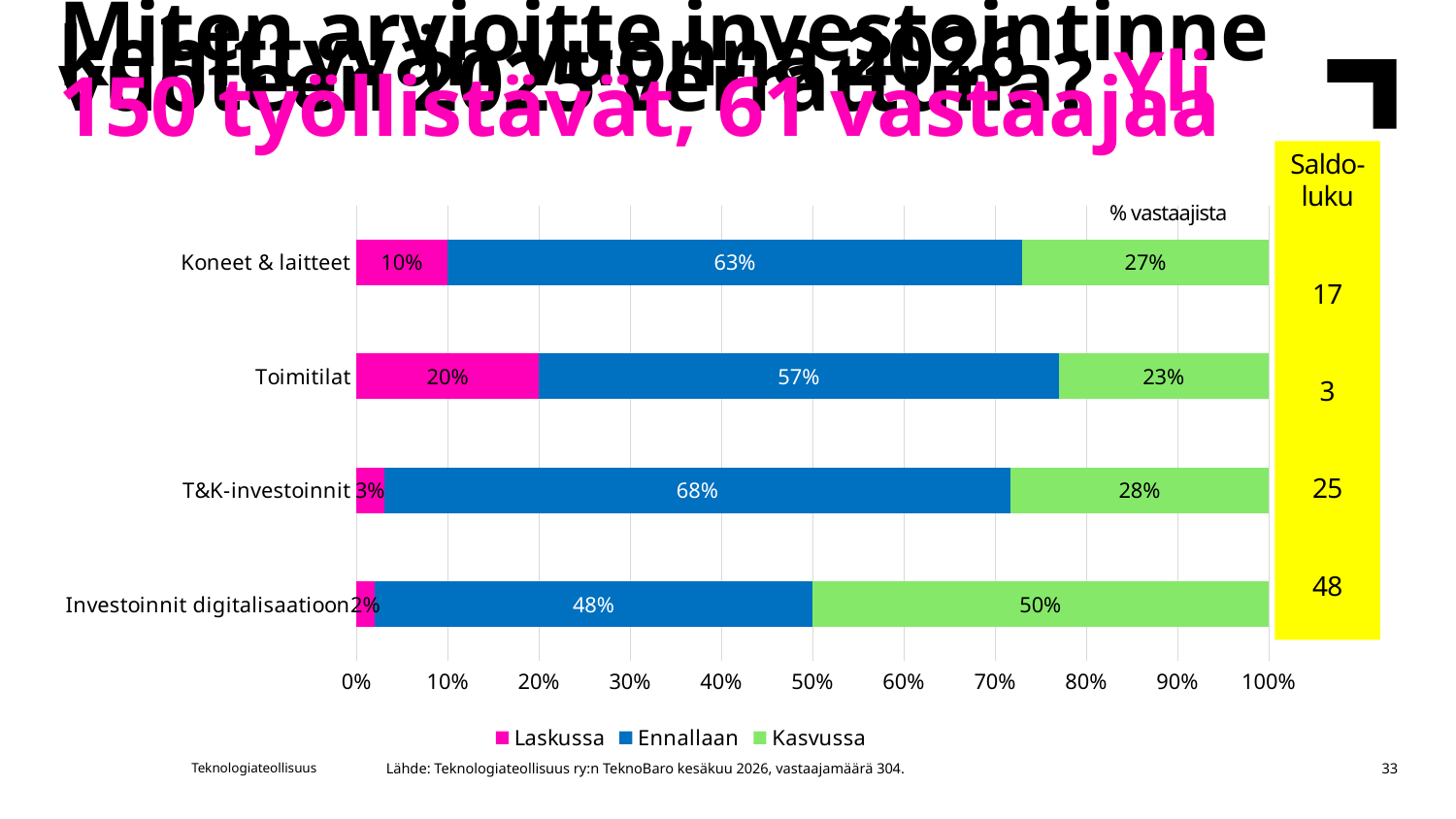
What is the Laskussa value for Toimitilat? 20% What is the Kasvussa value for Investoinnit digitalisaatioon? 50% How many categories are shown on the chart? 4 Which is larger, the Ennallaan value for T&K-investoinnit or for Toimitilat? T&K-investoinnit Which category has the highest Laskussa share? Toimitilat What is the Kasvussa value for T&K-investoinnit? 28% How many series does the legend list? 3 Which category has the lowest Ennallaan share? Investoinnit digitalisaatioon What is the difference between the Kasvussa values for Investoinnit digitalisaatioon and Koneet & laitteet? 23 percentage points Which colour represents the Kasvussa series in the chart? Green What kind of chart is shown on the slide? Stacked bar chart What percentage of respondents answered Ennallaan for Koneet & laitteet? 63%